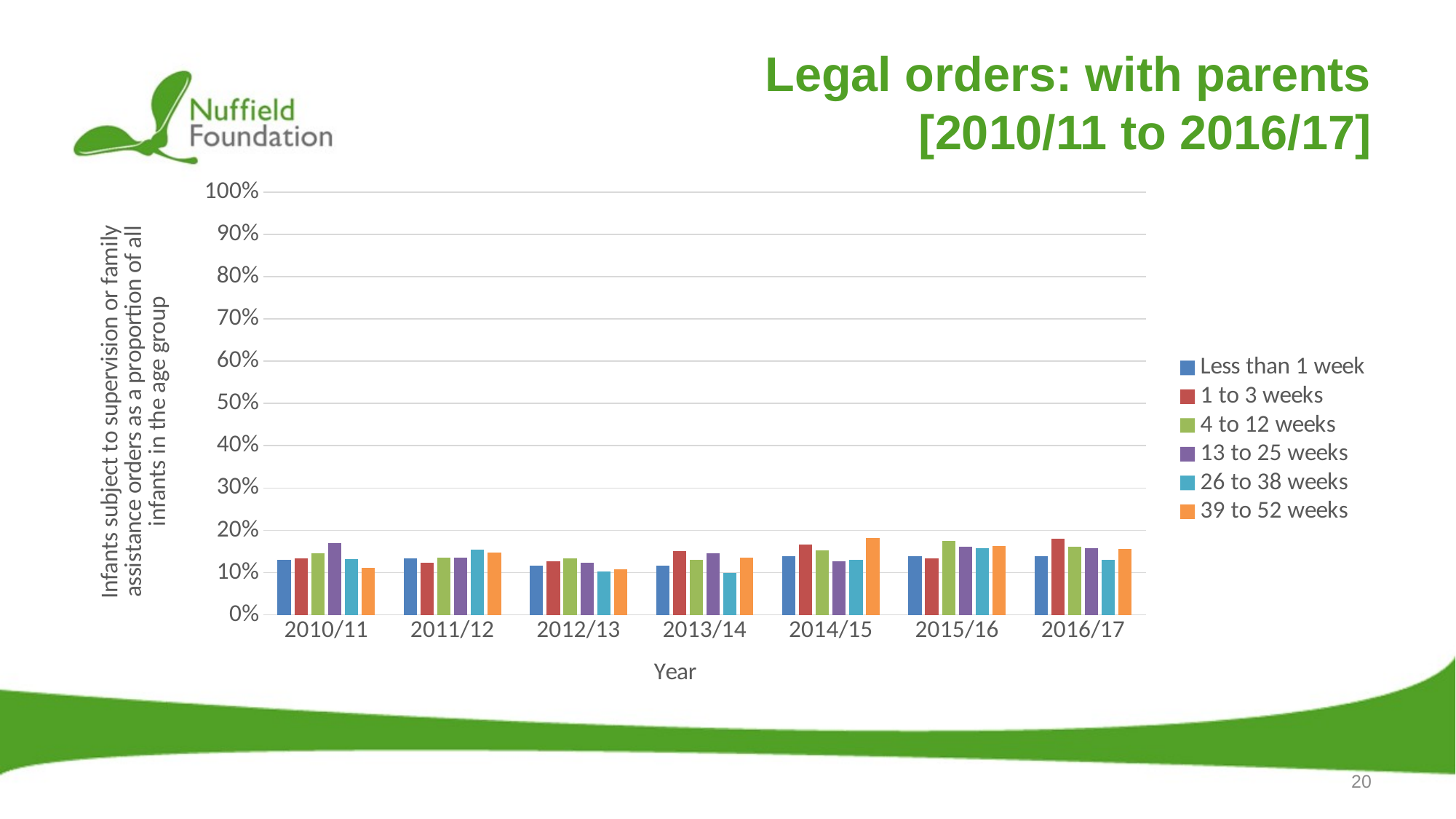
What is the title of the chart on the slide? Legal orders: with parents [2010/11 to 2016/17] Which series has the highest value in 2014/15? 39 to 52 weeks Which is larger: the value for 39 to 52 weeks in 2010/11 or in 2014/15? 2014/15 What kind of chart is shown on the slide? Bar chart Which is larger in 2013/14: the value for 1 to 3 weeks or for 26 to 38 weeks? 1 to 3 weeks Which series has the highest value in 2010/11? 13 to 25 weeks How many series does the chart's legend list? 6 Is the value for 13 to 25 weeks in 2010/11 greater or less than 10%? greater Is the value for 39 to 52 weeks in 2014/15 greater or less than 20%? less What is the label of the x axis? Year Is the value for 1 to 3 weeks in 2016/17 greater or less than 20%? less How many years are shown on the x axis of the chart? 7